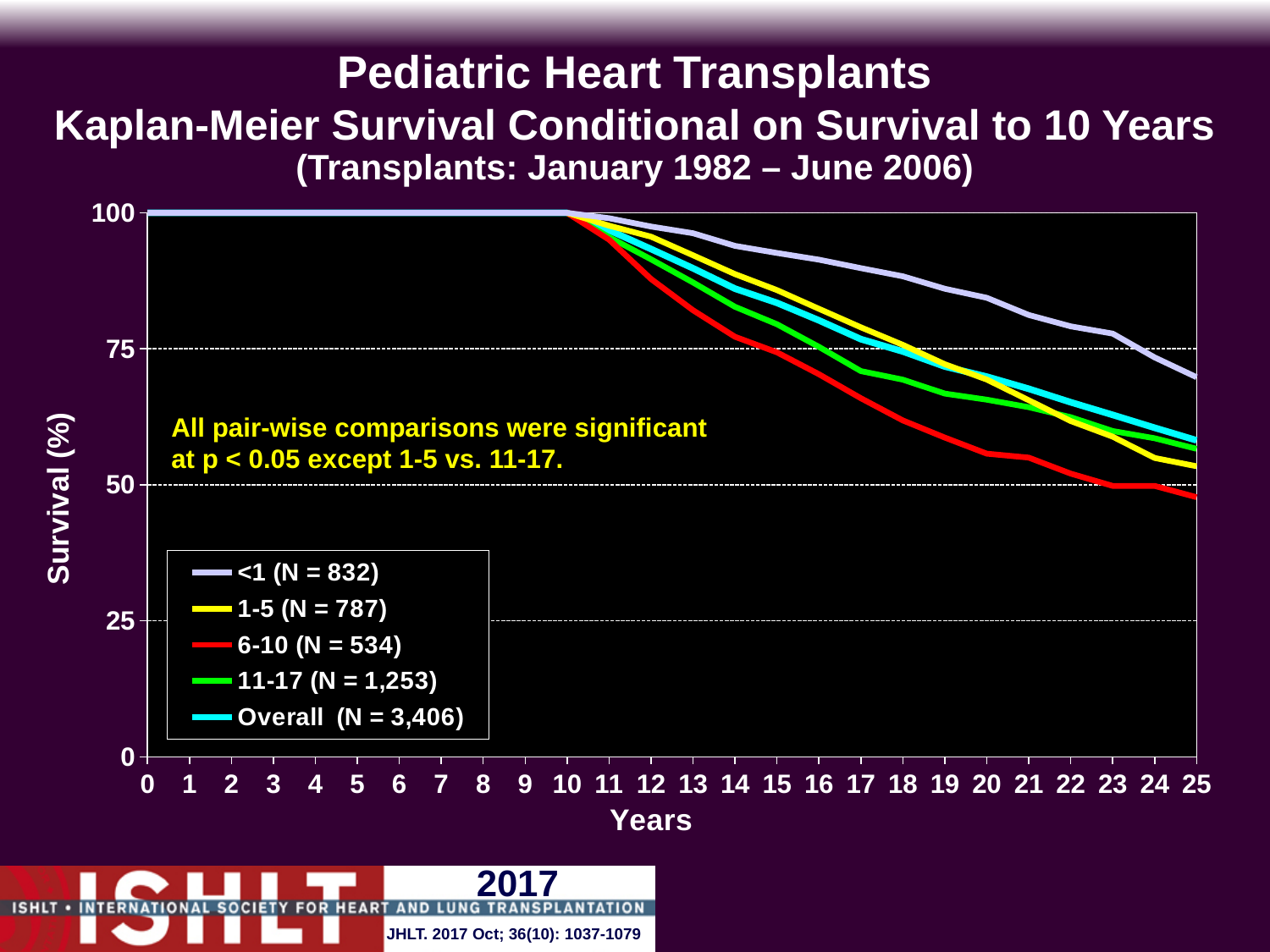
Which series has the highest survival at year 25? <1 (N = 832) At year 20, which series has the larger survival value, <1 or 6-10? <1 How many series does the legend list? 5 Is the survival value for the <1 series at year 20 greater or less than 75? greater What is the N shown in the legend for the Overall series? 3,406 What kind of chart is shown on the slide? line chart Is the survival value for the <1 series at year 25 greater or less than 75? less Do the survival curves rise or fall along the x axis after year 10? fall What is the survival value for the Overall series at year 10? 100 Which series has the lowest survival at year 25? 6-10 (N = 534) Is the survival value for the 6-10 series at year 17 greater or less than 75? less